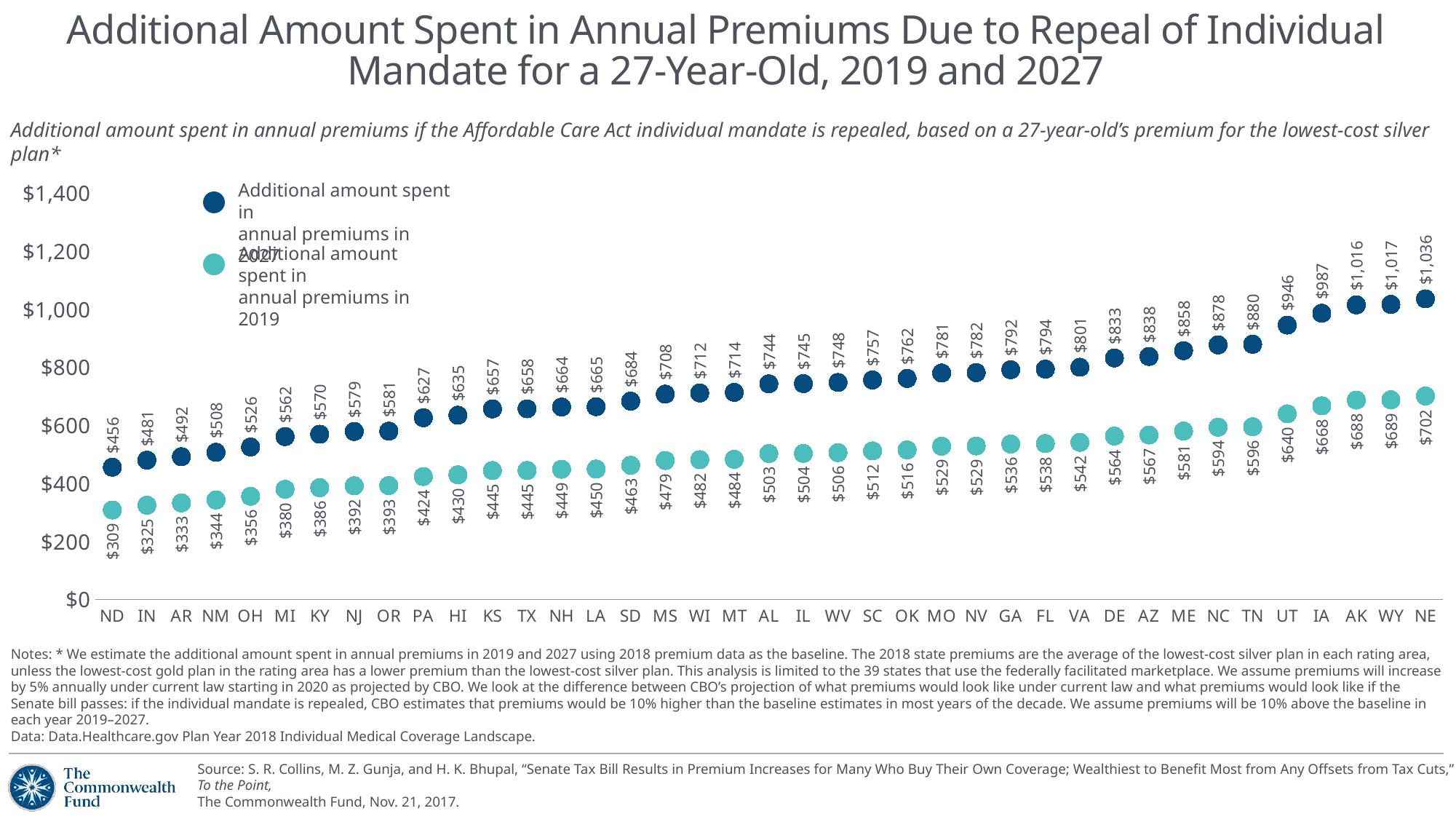
Which state has the lowest additional amount spent in annual premiums in 2019? ND Which is larger: the 2027 additional amount for Utah (UT) or for Tennessee (TN)? UT How many series does the legend list? 2 What kind of chart is shown on the slide? Scatter (dot) chart Is the 2019 additional amount for Iowa (IA) greater or less than $600? greater What is the additional amount spent in annual premiums in 2019 for Ohio (OH)? $356 What is the additional amount spent in annual premiums in 2027 for Texas (TX)? $658 Which colour represents the additional amount spent in annual premiums in 2019? Teal (light blue-green) Do the 2027 additional amounts rise or fall moving from left to right along the x axis? Rise How many states are shown on the x axis of the chart? 39 What is the difference between the 2027 and 2019 additional amounts for Nebraska (NE)? $334 Which state has the highest additional amount spent in annual premiums in 2027? NE